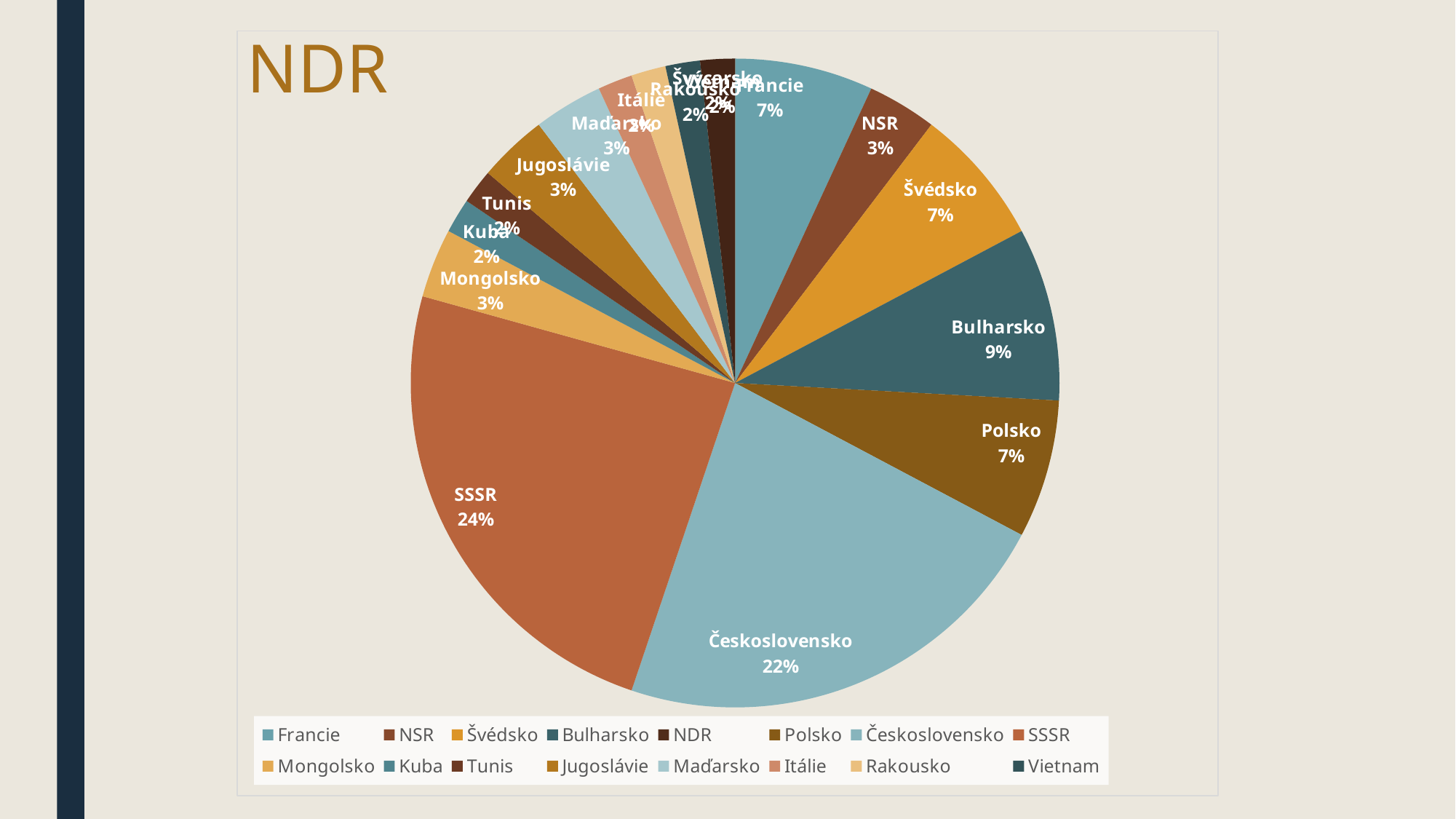
What is the value shown for Kuba? 2% What kind of chart is shown on the slide? pie chart What is the difference between the SSSR share and the Bulharsko share? 15% What share of the pie does SSSR have? 24% How many entries does the legend list? 16 What is the value shown for Mongolsko? 3% What is the title of the chart? NDR Which category has the largest slice of the pie? SSSR What is the value shown for Polsko? 7% Which is larger, the slice for SSSR or the slice for Československo? SSSR What share of the pie does Československo have? 22% What is the value shown for Bulharsko? 9%